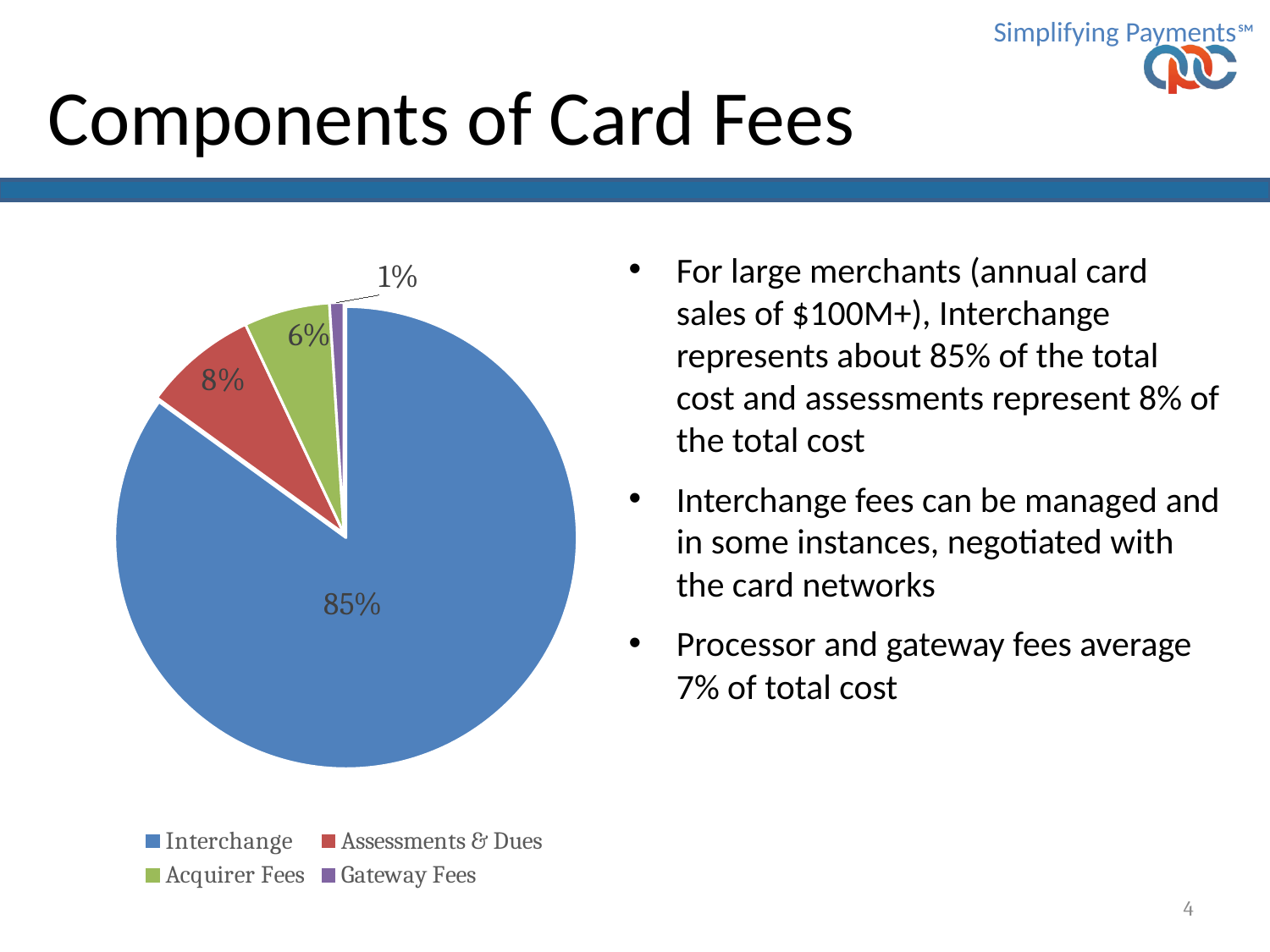
Which category has the largest slice of the pie? Interchange What kind of chart is shown on the slide? pie chart Which category is shown in green in the legend? Acquirer Fees Which is larger, Assessments & Dues or Acquirer Fees? Assessments & Dues How many slices does the pie chart have? 4 What share of the pie does Acquirer Fees represent? 6% What colour is the Interchange slice in the pie chart? blue What share of the pie does Interchange represent? 85% What share of the pie does Gateway Fees represent? 1% What is the difference in percentage points between Interchange and Assessments & Dues? 77 Which category has the smallest slice of the pie? Gateway Fees